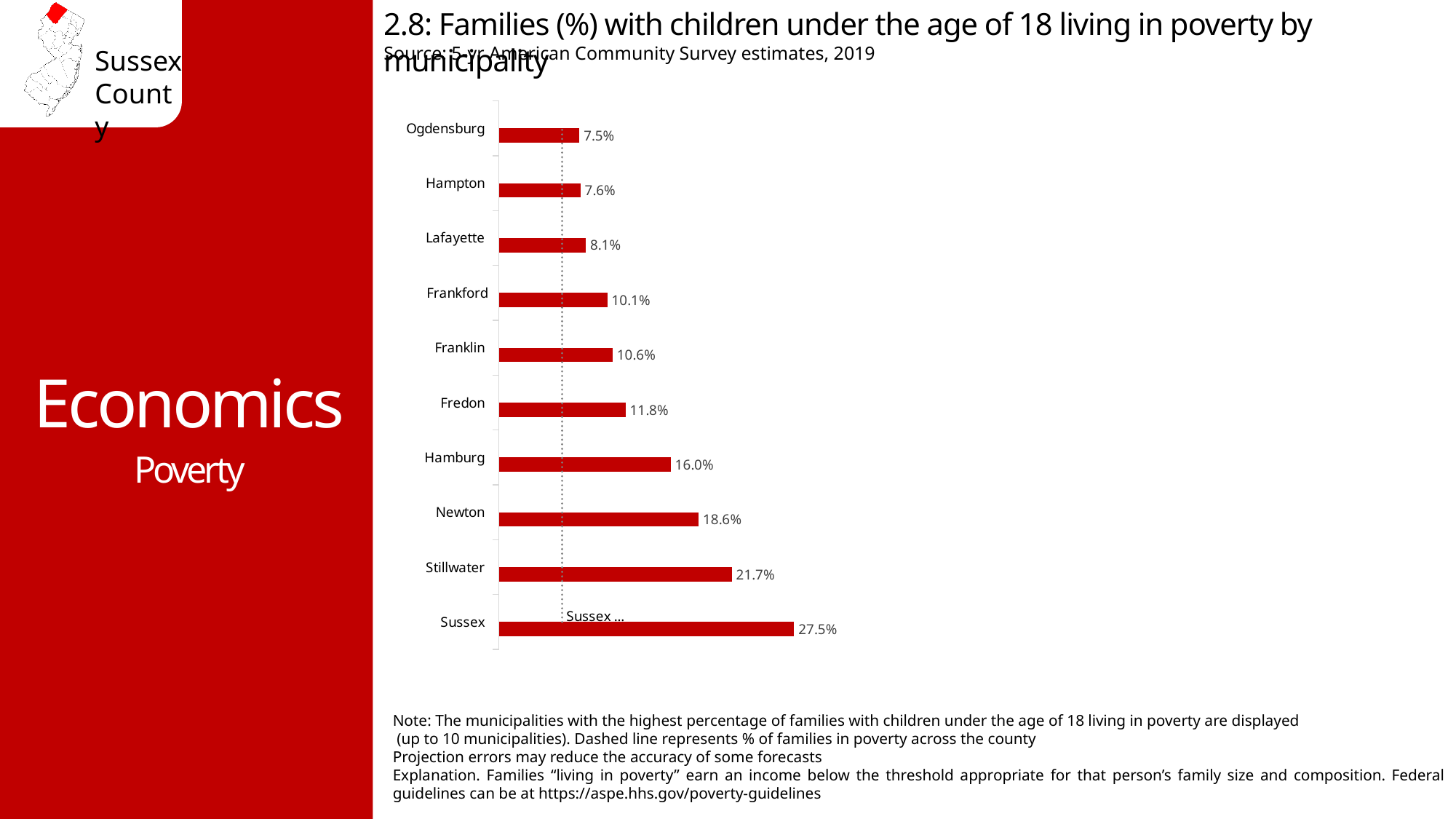
What is the value for Frankford? 10.1% Which municipality has the highest percentage of families with children under 18 living in poverty? Sussex What is the difference between the values for Sussex and Stillwater? 5.8% Which municipality has the lowest percentage of families with children under 18 living in poverty? Ogdensburg How many municipalities are shown in the chart? 10 What is the value for Sussex? 27.5% Which has a larger value, Hampton or Newton? Newton What kind of chart is shown on the slide? Bar chart What does the dashed vertical line in the chart represent? % of families in poverty across the county What is the value for Hamburg? 16.0% What is the difference between the values for Newton and Fredon? 6.8% Which has a larger value, Franklin or Lafayette? Franklin